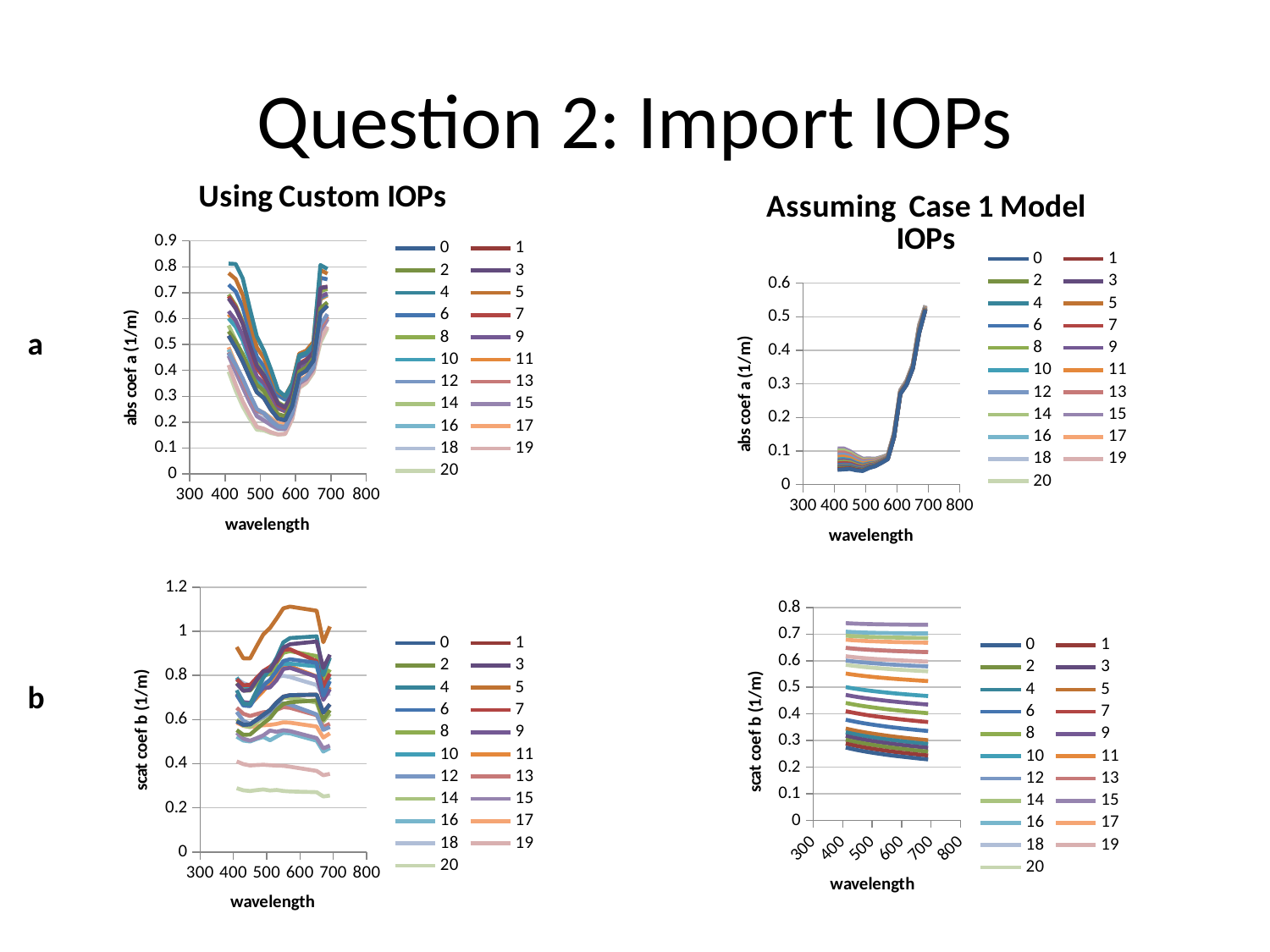
How many series does the legend of the top-left "Using Custom IOPs" chart list? 21 In the bottom-right scat coef b chart under "Assuming Case 1 Model IOPs", do the values rise or fall as wavelength increases? fall In the bottom-left scat coef b chart under "Using Custom IOPs", which series has the highest values? 5 In the top-right abs coef a chart under "Assuming Case 1 Model IOPs", are the values at 700 nm greater or less than 0.4? greater In the bottom-left scat coef b chart under "Using Custom IOPs", which series has the lowest values? 20 In the bottom-left scat coef b chart under "Using Custom IOPs", is the value for series 20 greater or less than 0.4? less In the top-right abs coef a chart under "Assuming Case 1 Model IOPs", are the values at 500 nm greater or less than 0.2? less How many series does the legend of the bottom-right scat coef b chart under "Assuming Case 1 Model IOPs" list? 21 What kind of chart is the top-left chart titled "Using Custom IOPs"? line chart What is the y-axis label of the top-left chart under "Using Custom IOPs"? abs coef a (1/m) In the top-right abs coef a chart under "Assuming Case 1 Model IOPs", do the values rise or fall between 600 and 700 nm? rise